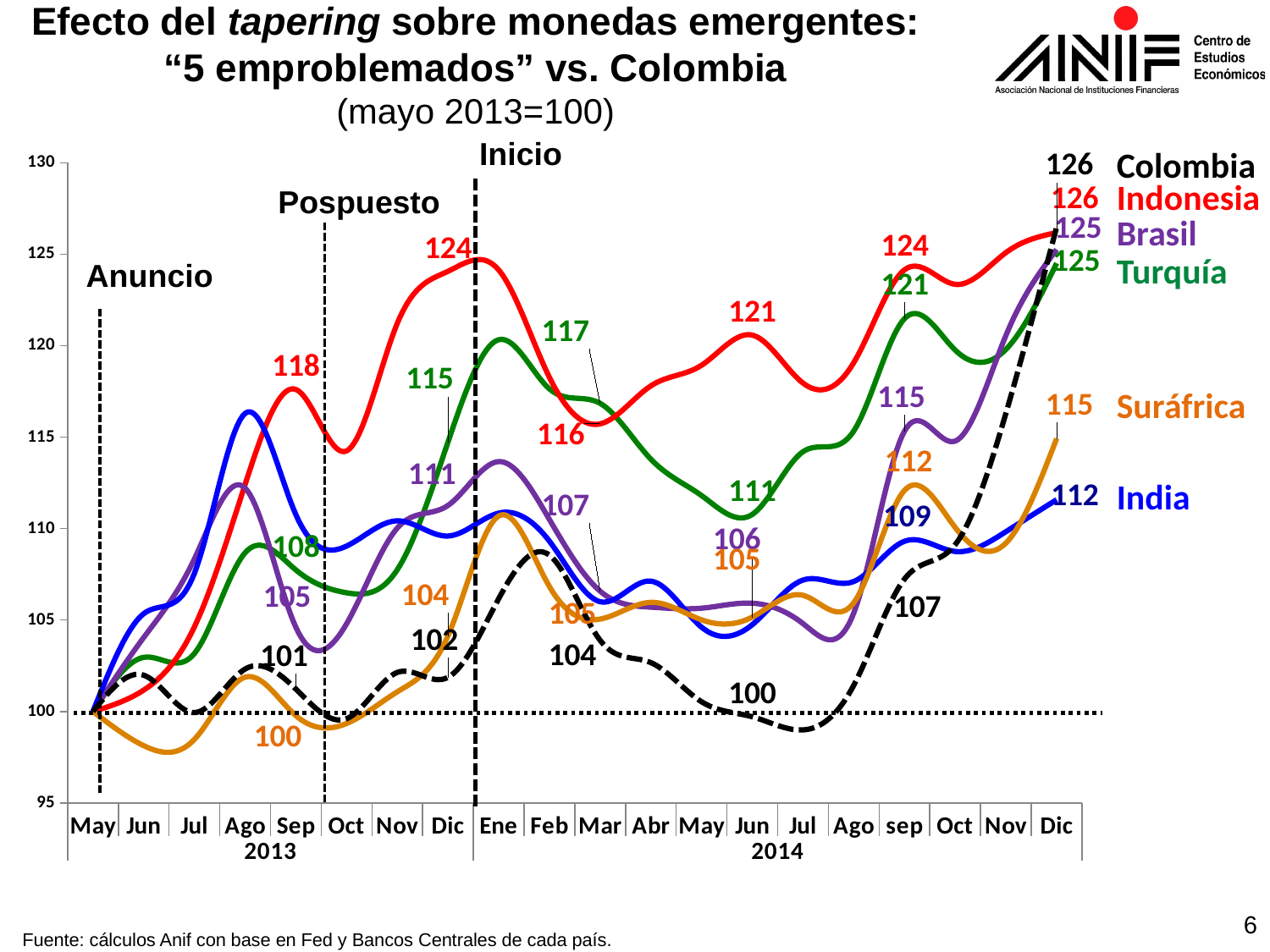
What is the index value for Suráfrica at the end of the series (Dic 2014)? 115 In sep 2014, which is higher: Turquía or Brasil? Turquía What kind of chart is shown on the slide? line chart What is the labelled value for Indonesia in Sep 2013? 118 What is the index value for India at the end of the series (Dic 2014)? 112 What is the difference between the final values of Indonesia (126) and India (112)? 14 What is the labelled value for Colombia in Jun 2014? 100 What is the difference between the sep 2014 values of Suráfrica (112) and Colombia (107)? 5 Which country has the lowest index value at the end of the series (Dic 2014)? India Is the value for India in Jul 2014 greater or less than 110? less What is the base period of the index according to the subtitle? mayo 2013=100 How many countries (series) are plotted on the chart? 6